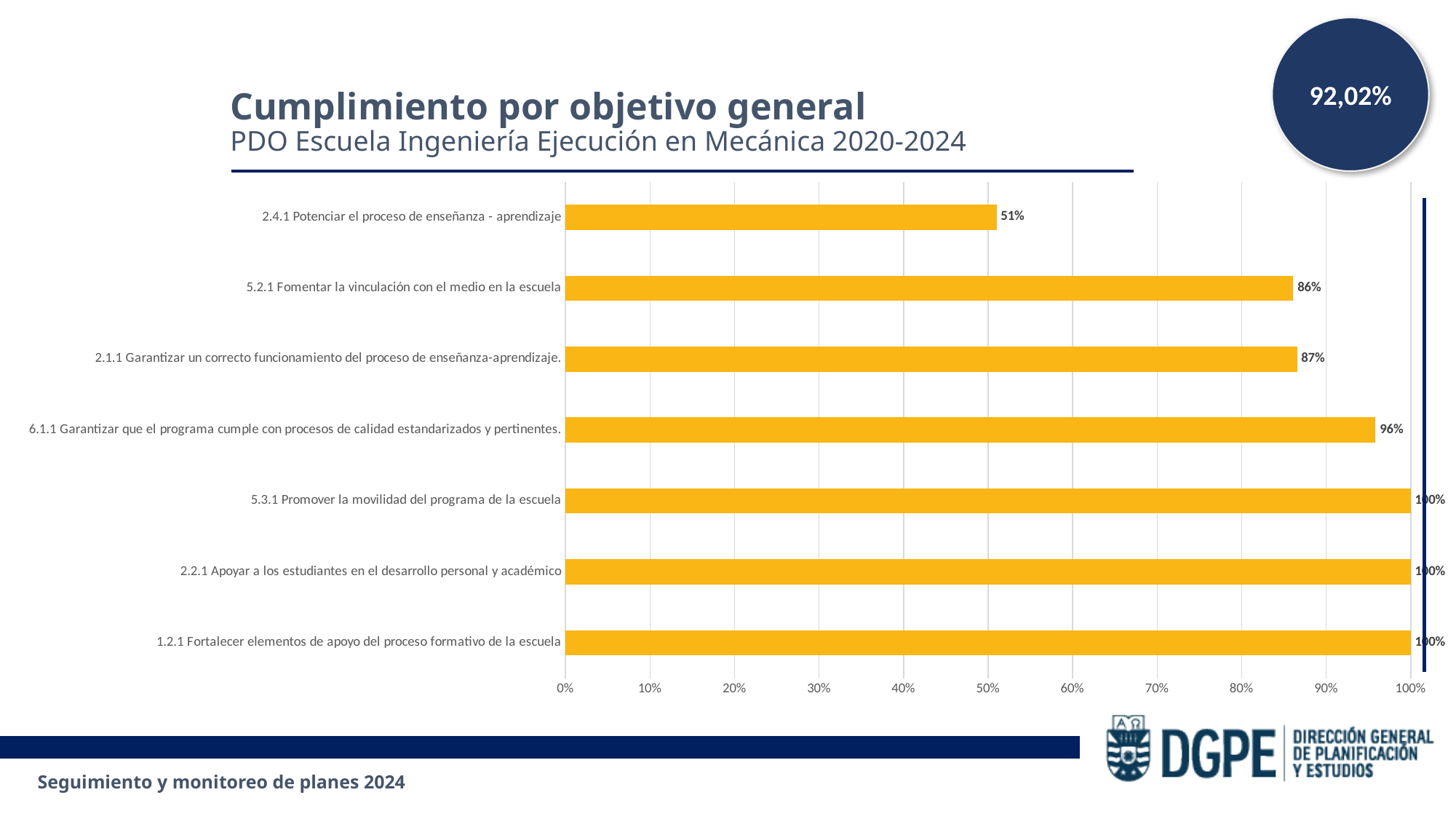
Is the value for 2.4.1 Potenciar el proceso de enseñanza - aprendizaje greater or less than 60%? less What is the value for 5.2.1 Fomentar la vinculación con el medio en la escuela? 86% What kind of chart is shown on the slide? bar chart What overall percentage is shown in the circle at the top right of the slide? 92,02% How many objectives are shown in the chart? 7 What is the difference between the values for 6.1.1 and 2.4.1? 45% What is the value for 2.4.1 Potenciar el proceso de enseñanza - aprendizaje? 51% Which is larger, the value for 5.2.1 Fomentar la vinculación con el medio en la escuela or the value for 2.4.1 Potenciar el proceso de enseñanza - aprendizaje? 5.2.1 Fomentar la vinculación con el medio en la escuela What is the value for 6.1.1 Garantizar que el programa cumple con procesos de calidad estandarizados y pertinentes.? 96% What is the value for 2.1.1 Garantizar un correcto funcionamiento del proceso de enseñanza-aprendizaje.? 87% Which objective has the lowest value? 2.4.1 Potenciar el proceso de enseñanza - aprendizaje How many objectives have a value of 100%? 3